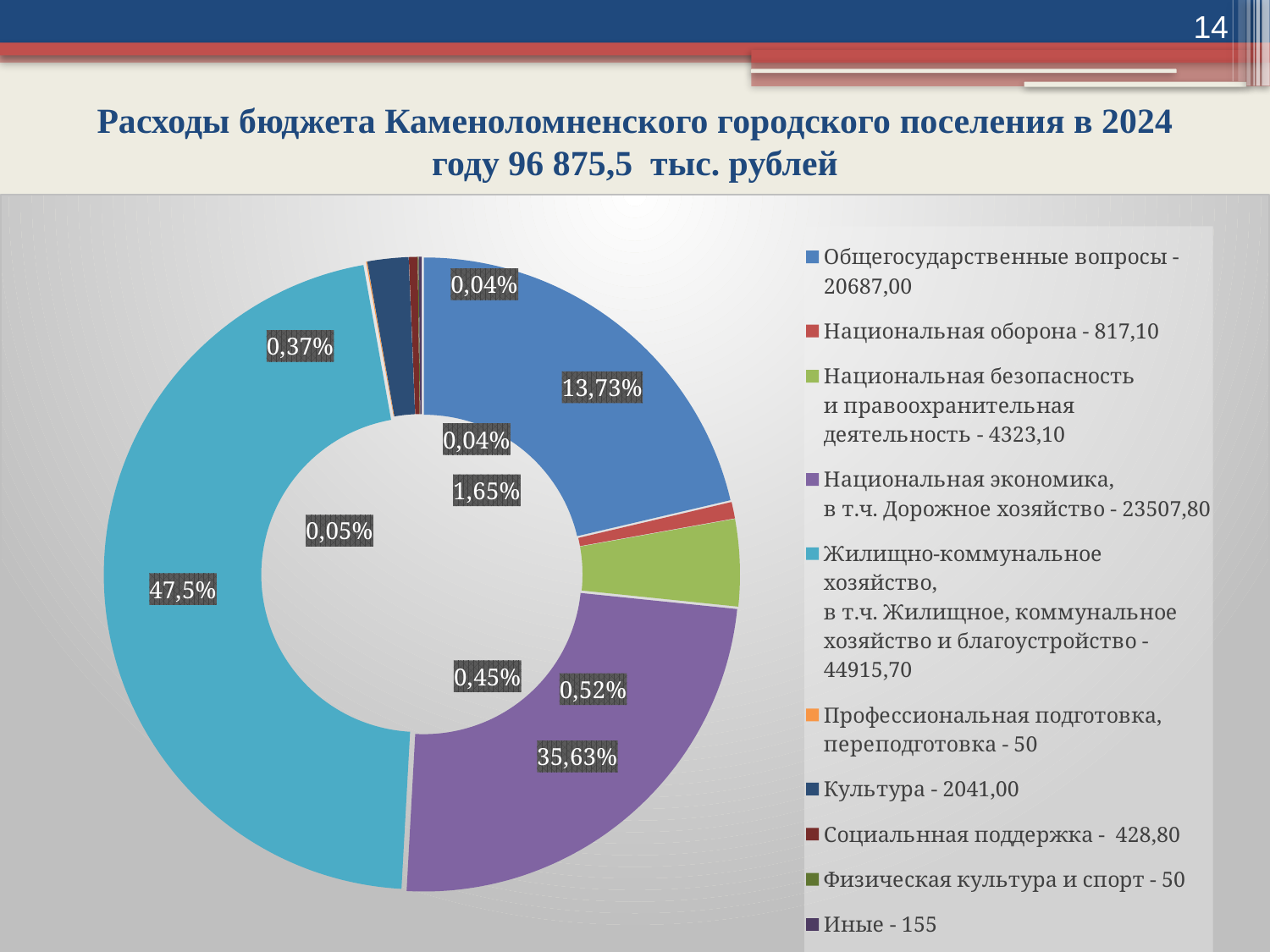
What is the difference between the legend values for Национальная экономика (23507,80) and Общегосударственные вопросы (20687,00)? 2820,80 Which category has the largest slice in the chart? Жилищно-коммунальное хозяйство What value does the legend give for Общегосударственные вопросы? 20687,00 What kind of chart is shown on the slide? Doughnut (pie) chart What percentage label is shown on the blue slice (Общегосударственные вопросы)? 13,73% What value does the legend give for Культура? 2041,00 What percentage label is shown on the largest (light blue) slice? 47,5% Which is larger according to the legend: Национальная экономика or Общегосударственные вопросы? Национальная экономика What total budget expenditure is stated in the slide title? 96 875,5 тыс. рублей What value does the legend give for Жилищно-коммунальное хозяйство? 44915,70 How many categories does the legend of the chart list? 10 What percentage label is shown on the purple slice (Национальная экономика)? 35,63%